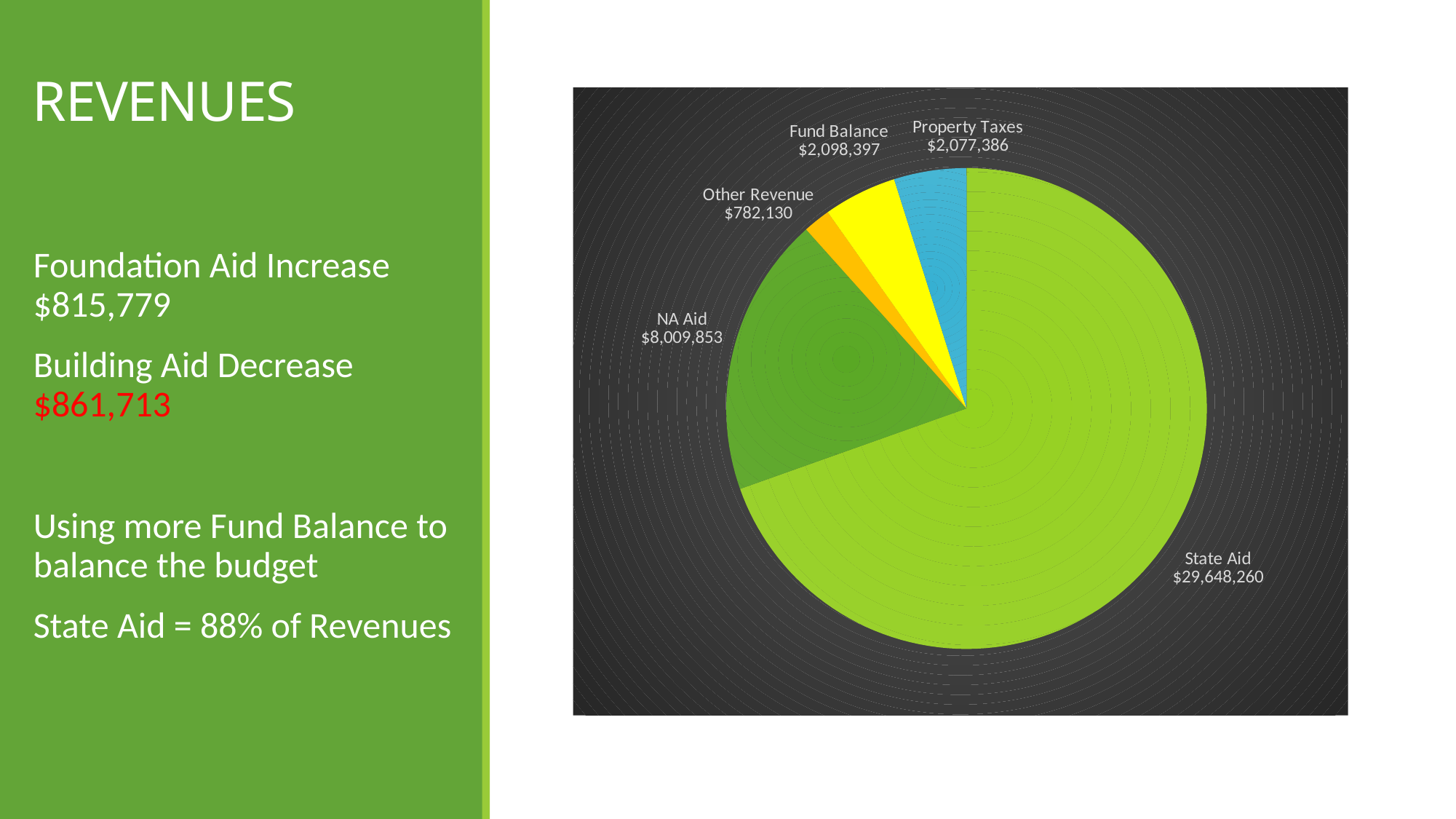
Which category has the smallest slice of the pie? Other Revenue Which category has the largest slice of the pie? State Aid What colour is the Property Taxes slice? blue What is the value shown for NA Aid? $8,009,853 What kind of chart is shown on the slide? pie chart What is the value shown for Other Revenue? $782,130 What is the value shown for State Aid? $29,648,260 Which is larger, NA Aid or Fund Balance? NA Aid What is the value shown for Property Taxes? $2,077,386 How many slices does the pie chart have? 5 What is the value shown for Fund Balance? $2,098,397 What is the difference between State Aid and NA Aid? $21,638,407